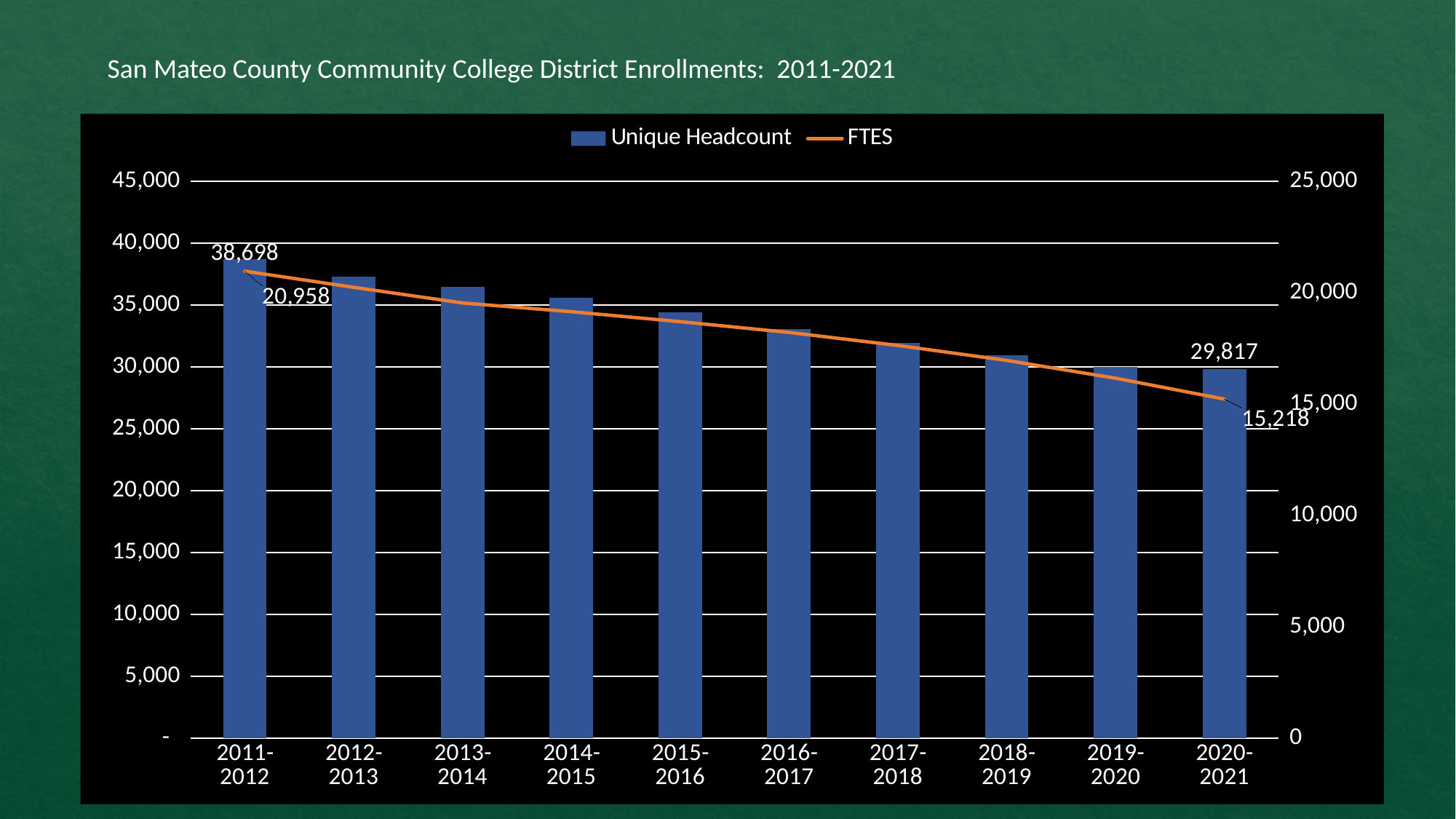
How many series does the legend list? 2 What is the difference between the FTES values for 2011-2012 and 2020-2021? 5,740 What is the FTES value for 2020-2021? 15,218 Is the Unique Headcount for 2016-2017 greater or less than 35,000? less How many academic years are shown on the x axis? 10 Which academic year has the lowest Unique Headcount? 2020-2021 What is the Unique Headcount for 2011-2012? 38,698 What is the overall trend of the FTES line from 2011-2012 to 2020-2021? Falling Which academic year has the highest Unique Headcount? 2011-2012 By how much did the Unique Headcount fall from 2011-2012 to 2020-2021? 8,881 What is the FTES value for 2011-2012? 20,958 What is the Unique Headcount for 2020-2021? 29,817